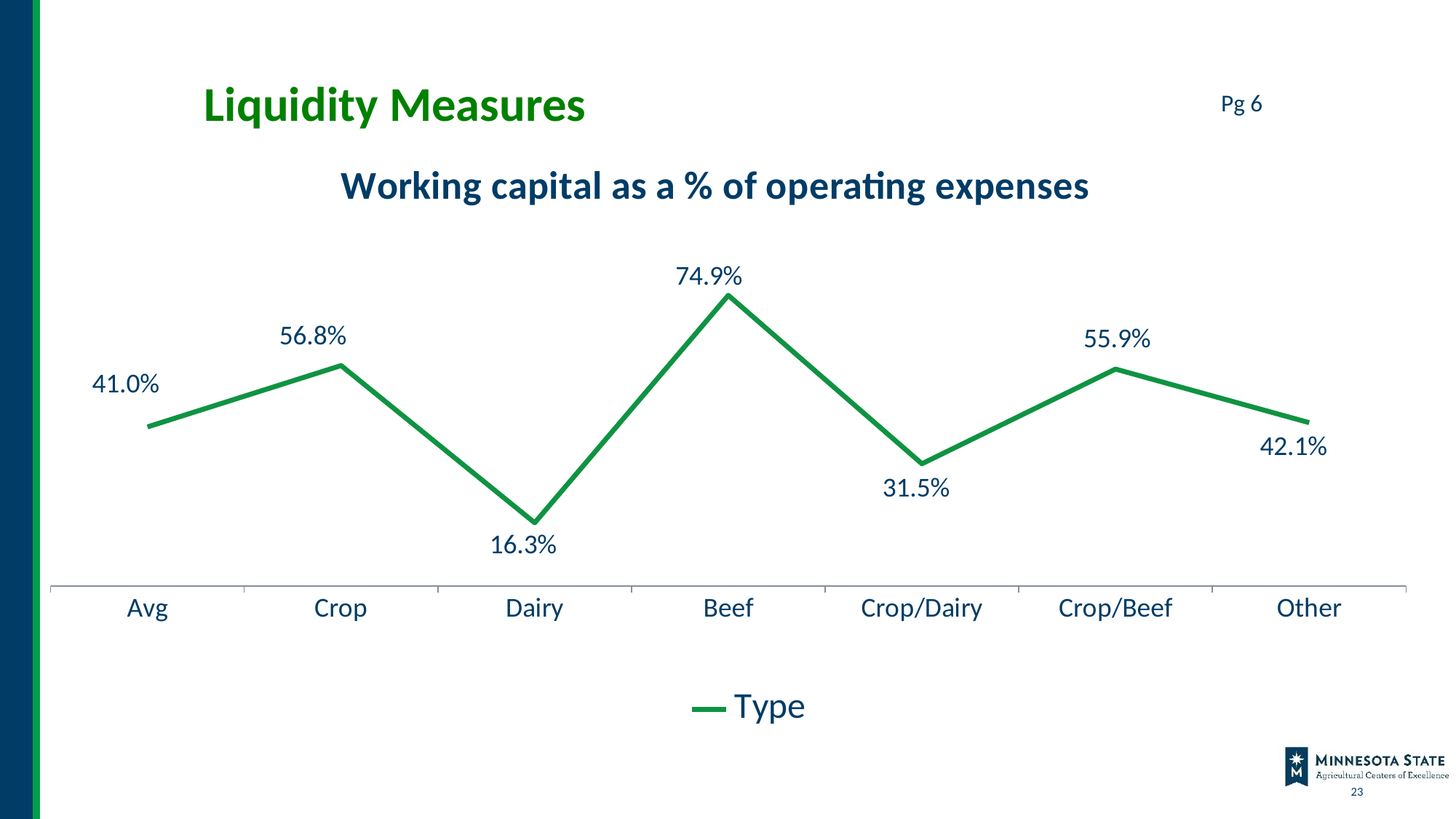
What is the difference between the values for Beef and Dairy? 58.6% What kind of chart is shown? Line chart Which category has the highest value? Beef How many categories are plotted on the x axis? 7 What is the value for Crop/Beef? 55.9% Which category has the lowest value? Dairy What is the working capital as a % of operating expenses for Beef? 74.9% What is the title of the chart? Working capital as a % of operating expenses What is the value for Avg? 41.0% Which is larger, the value for Other or the value for Crop/Dairy? Other What is the value for Dairy? 16.3% What is the difference between the values for Crop and Crop/Dairy? 25.3%